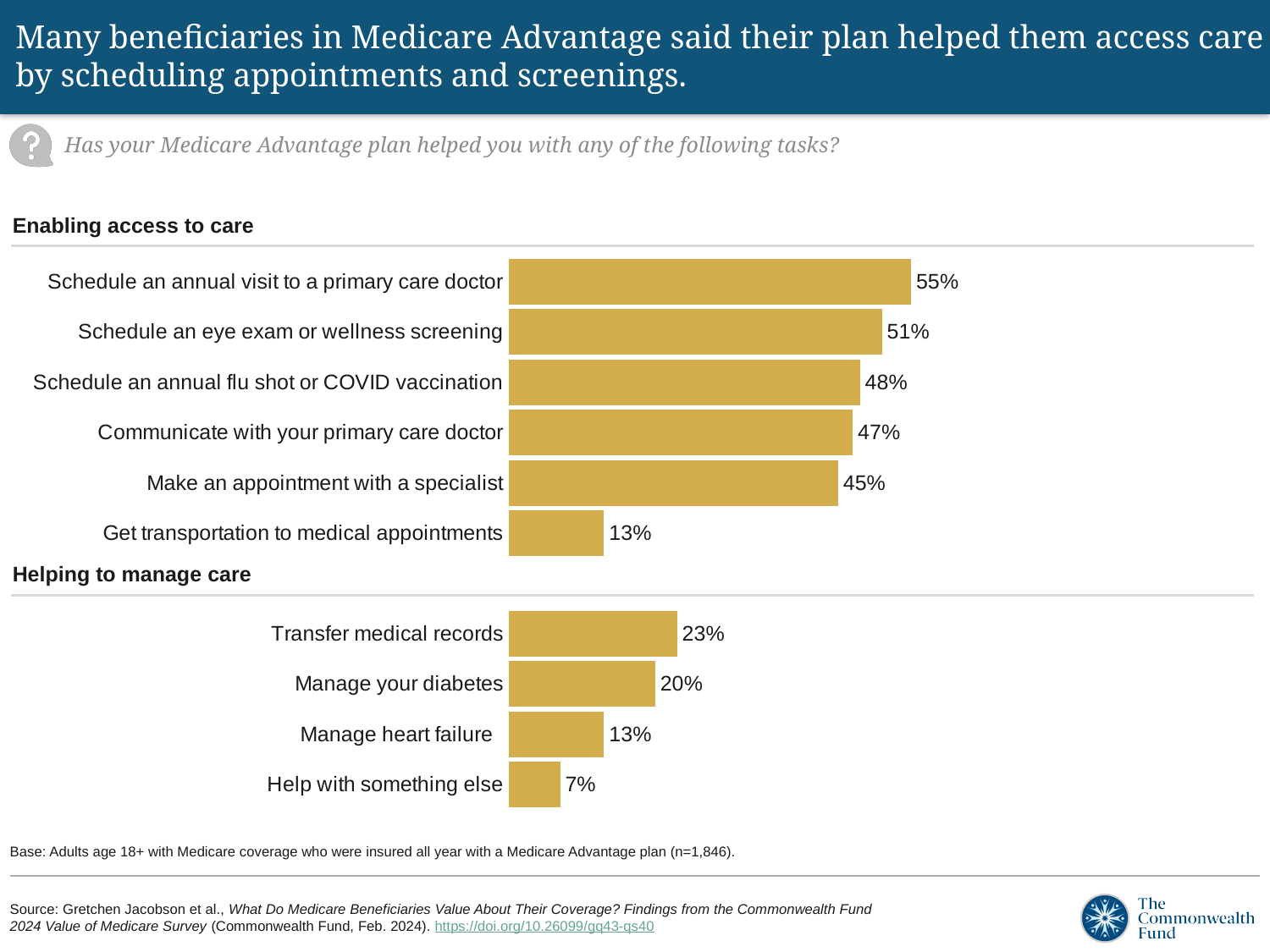
In the 'Enabling access to care' section, what percentage said their plan helped them schedule an annual visit to a primary care doctor? 55% In the 'Enabling access to care' section, what is the value for 'Get transportation to medical appointments'? 13% In the 'Helping to manage care' section, which task has the lowest value? Help with something else How many tasks are listed in the 'Helping to manage care' section? 4 What is the difference between the values for 'Transfer medical records' and 'Manage heart failure'? 10 percentage points In the 'Helping to manage care' section, which task has the highest value? Transfer medical records How many tasks are listed in the 'Enabling access to care' section? 6 What is the difference between the values for 'Schedule an annual visit to a primary care doctor' and 'Make an appointment with a specialist'? 10 percentage points In the 'Helping to manage care' section, what percentage said their plan helped them manage their diabetes? 20% Which is larger: the value for 'Schedule an eye exam or wellness screening' or the value for 'Communicate with your primary care doctor'? Schedule an eye exam or wellness screening In the 'Enabling access to care' section, which task has the lowest value? Get transportation to medical appointments What type of chart is shown on the slide? Bar chart